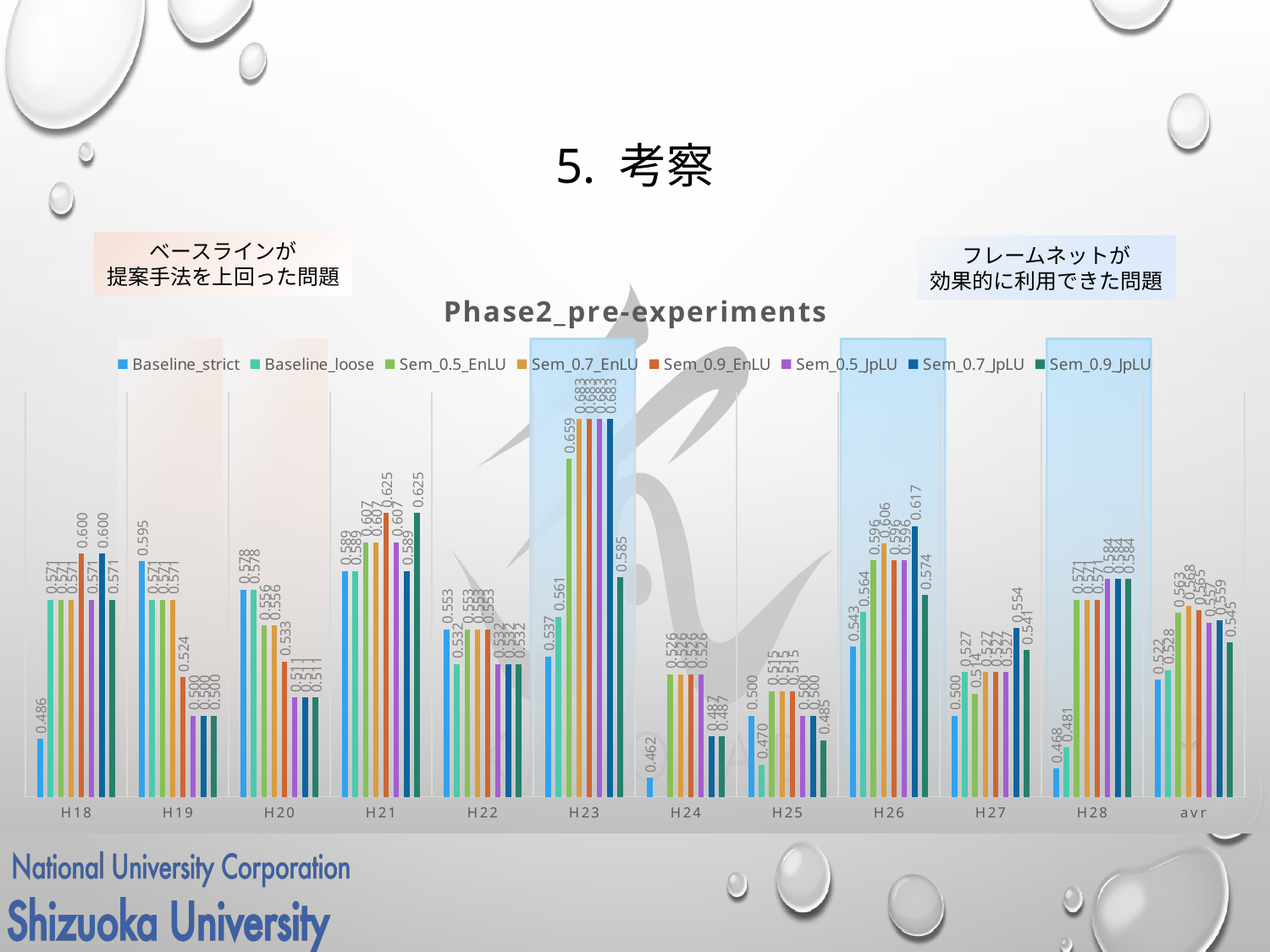
How many series does the legend of the chart list? 8 What is the value of Baseline_strict for H24? 0.462 What is the value of Baseline_strict for H18? 0.486 What is the title of the chart? Phase2_pre-experiments What kind of chart is shown on the slide? bar chart What is the value of Sem_0.7_EnLU for H23? 0.683 For the Baseline_strict series, which category has the highest value? H19 For H19, which is larger: Baseline_strict or Sem_0.9_EnLU? Baseline_strict For H18, what is the difference between Sem_0.9_EnLU and Baseline_strict? 0.114 For the Baseline_strict series, which category has the lowest value? H24 How many categories are shown along the x axis of the chart? 12 What is the value of Sem_0.7_JpLU for H26? 0.617